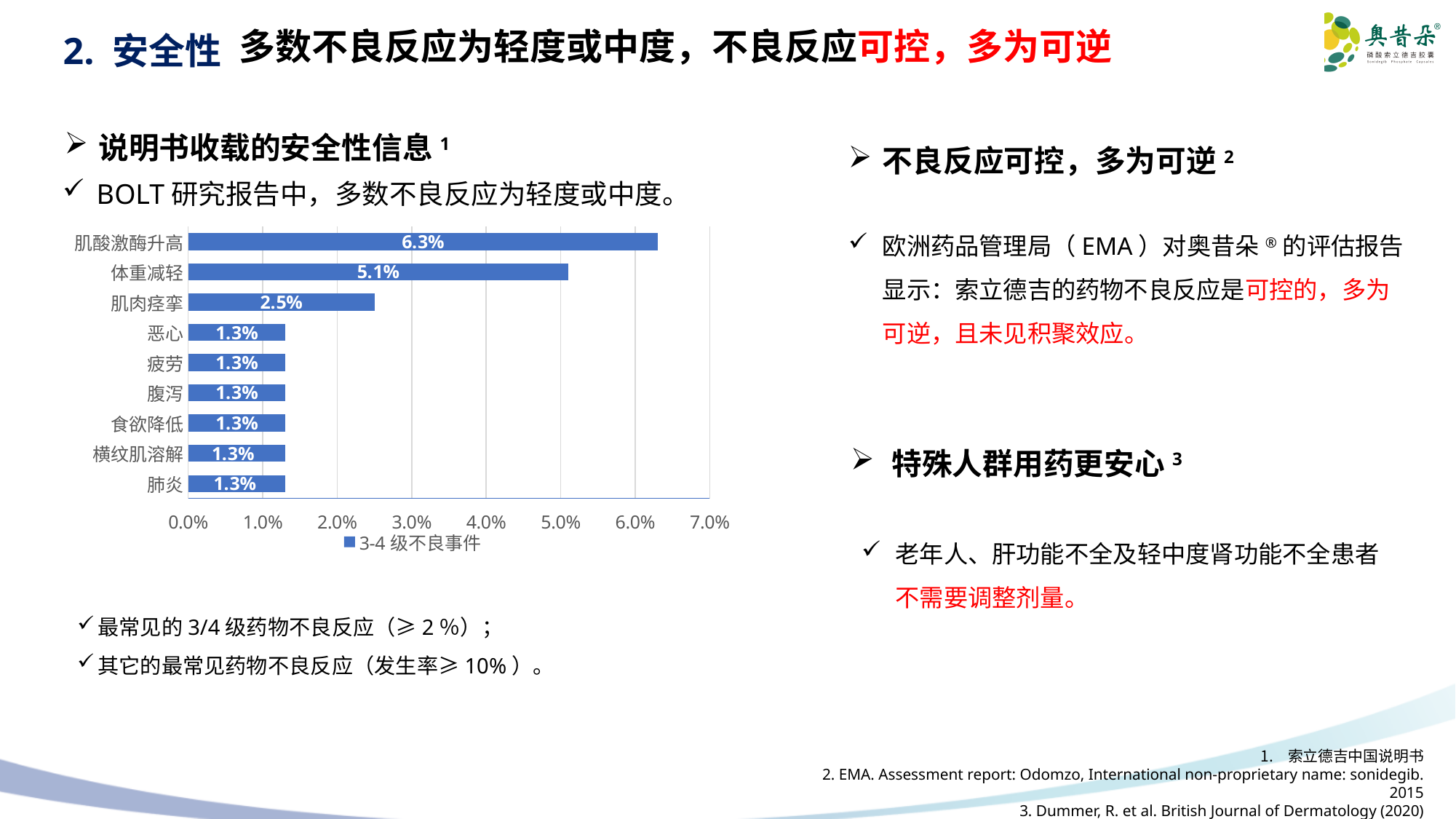
What kind of chart is shown on the slide? bar chart What is the value for 肌酸激酶升高? 6.3% What is the value for 肌肉痉挛? 2.5% What is the legend entry for the series in the chart? 3-4 级不良事件 How many categories are shown in the chart? 9 Which category has the highest value? 肌酸激酶升高 What is the difference between the values for 体重减轻 and 肌肉痉挛? 2.6% What is the difference between the values for 肌酸激酶升高 and 体重减轻? 1.2% Is the value for 肌酸激酶升高 greater or less than 6.0%? greater What is the value for 肺炎? 1.3% Which is larger, the value for 肌肉痉挛 or the value for 恶心? 肌肉痉挛 What is the value for 体重减轻? 5.1%